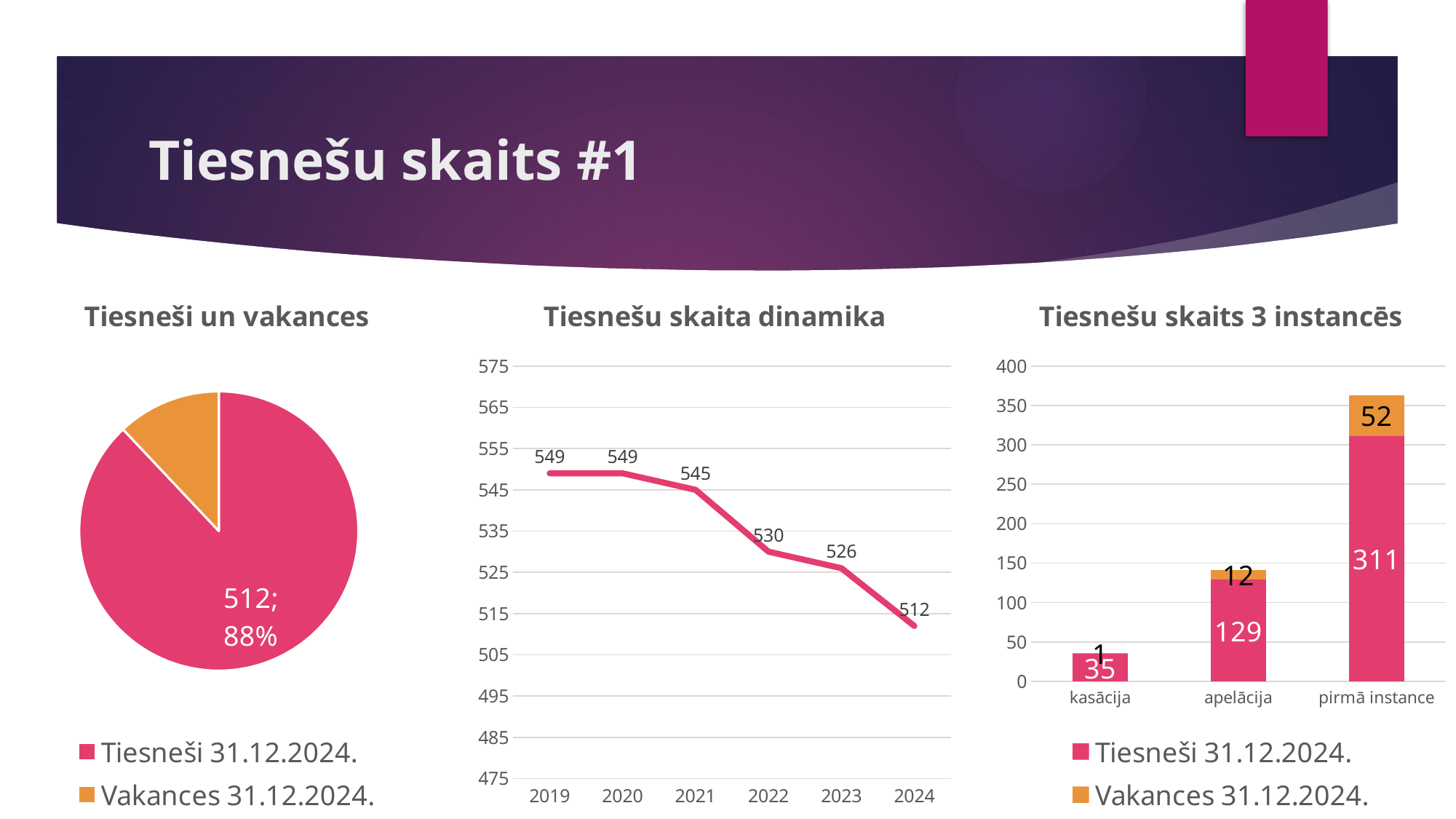
In the 'Tiesnešu skaita dinamika' chart, which year has the lowest value? 2024 In the 'Tiesnešu skaits 3 instancēs' chart, what is the Tiesneši 31.12.2024. value for apelācija? 129 In the 'Tiesnešu skaits 3 instancēs' chart, what is the total of the stacked bar for pirmā instance? 363 What kind of chart is 'Tiesnešu skaits 3 instancēs'? Stacked bar chart How many entries does the legend of the 'Tiesneši un vakances' chart list? 2 In the 'Tiesnešu skaita dinamika' chart, what is the difference between the 2019 value and the 2024 value? 37 What kind of chart is 'Tiesneši un vakances'? Pie chart How many years are plotted in the 'Tiesnešu skaita dinamika' chart? 6 In the 'Tiesnešu skaita dinamika' chart, do the values rise or fall from 2019 to 2024? Fall In the 'Tiesnešu skaits 3 instancēs' chart, which category has the highest Vakances 31.12.2024. value? pirmā instance In the 'Tiesneši un vakances' chart, what value and share are shown for Tiesneši 31.12.2024.? 512; 88% In the 'Tiesnešu skaita dinamika' chart, what is the value for 2021? 545